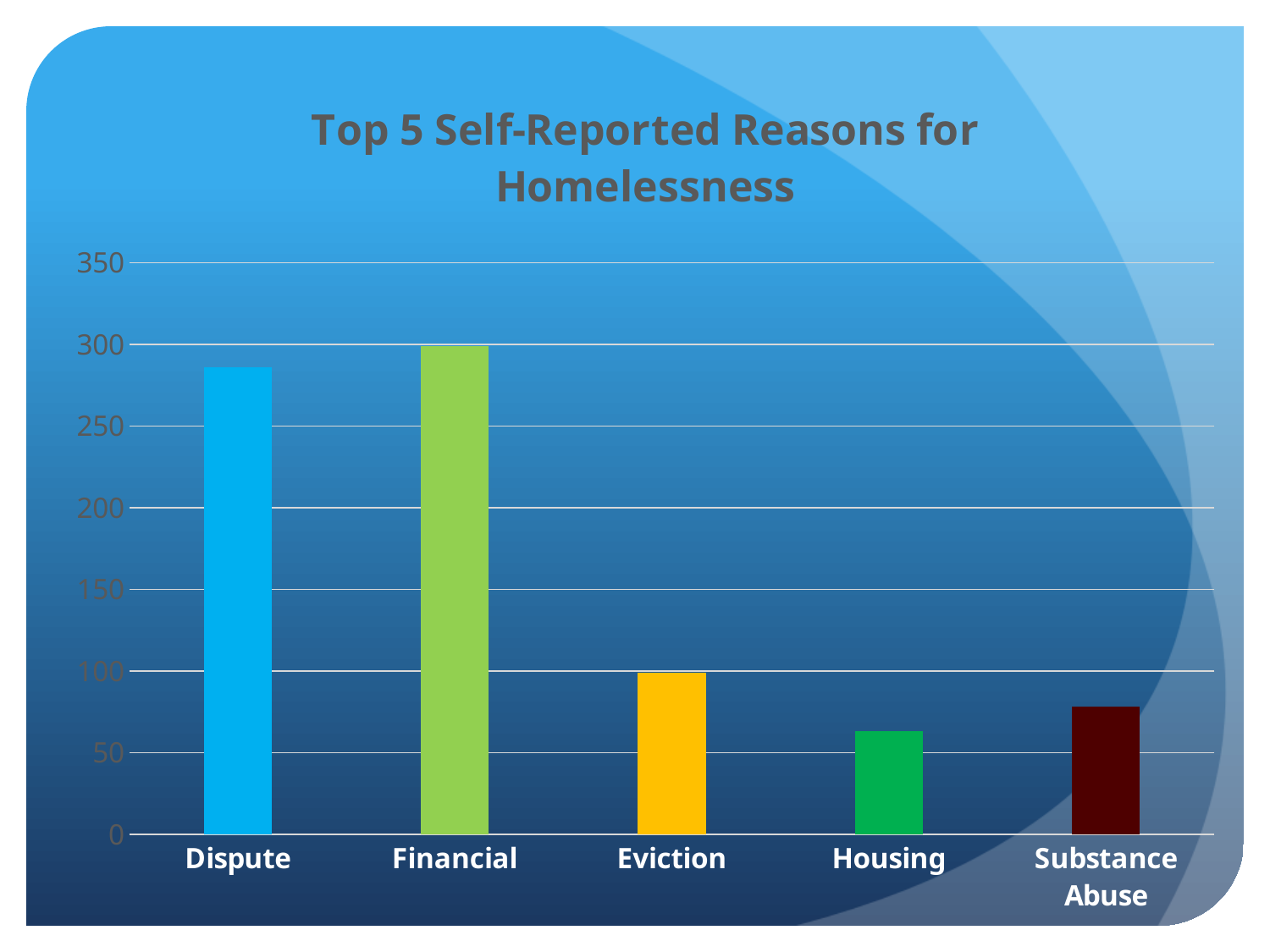
Which category has the lowest value? Housing Is the value for Dispute greater or less than 300? less Is the value for Financial greater or less than 250? greater Which is larger, the value for Eviction or the value for Substance Abuse? Eviction Is the value for Housing greater or less than 100? less What type of chart is shown on the slide? bar chart How many categories are shown on the x axis of the chart? 5 Which category has the highest value? Financial Which is larger, the value for Housing or the value for Substance Abuse? Substance Abuse What is the title of the chart? Top 5 Self-Reported Reasons for Homelessness